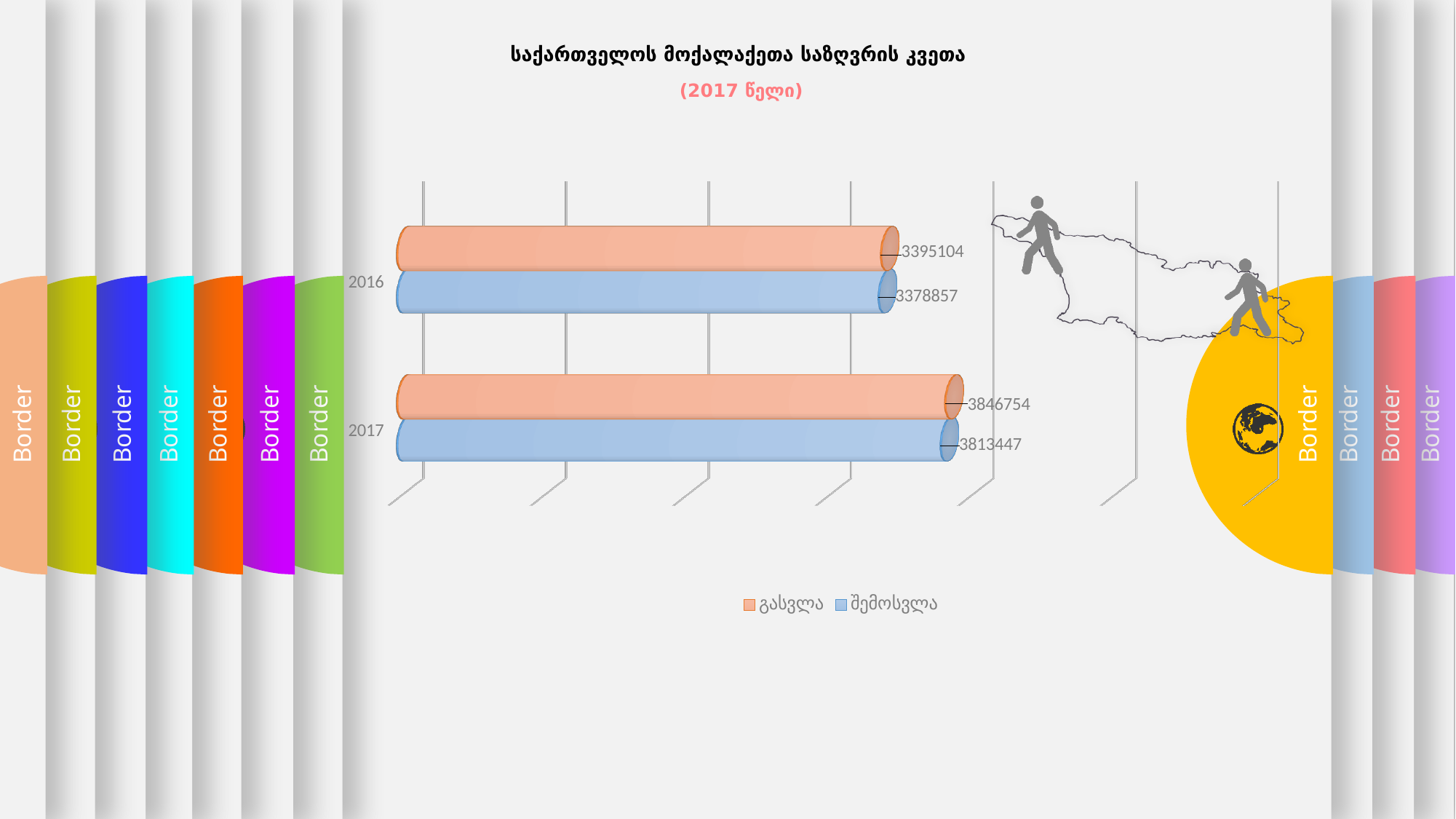
What is the difference between გასვლა and შემოსვლა in 2017? 33307 Which year has the higher value for გასვლა? 2017 How many series does the legend list? 2 What is the difference between the გასვლა values for 2017 and 2016? 451650 What kind of chart is shown on the slide? Bar chart Which year has the lower value for შემოსვლა? 2016 Which is larger in 2016, გასვლა or შემოსვლა? გასვლა What is the value for გასვლა in 2017? 3846754 What is the value for შემოსვლა in 2017? 3813447 How many years are shown on the chart? 2 What is the value for გასვლა in 2016? 3395104 What is the value for შემოსვლა in 2016? 3378857